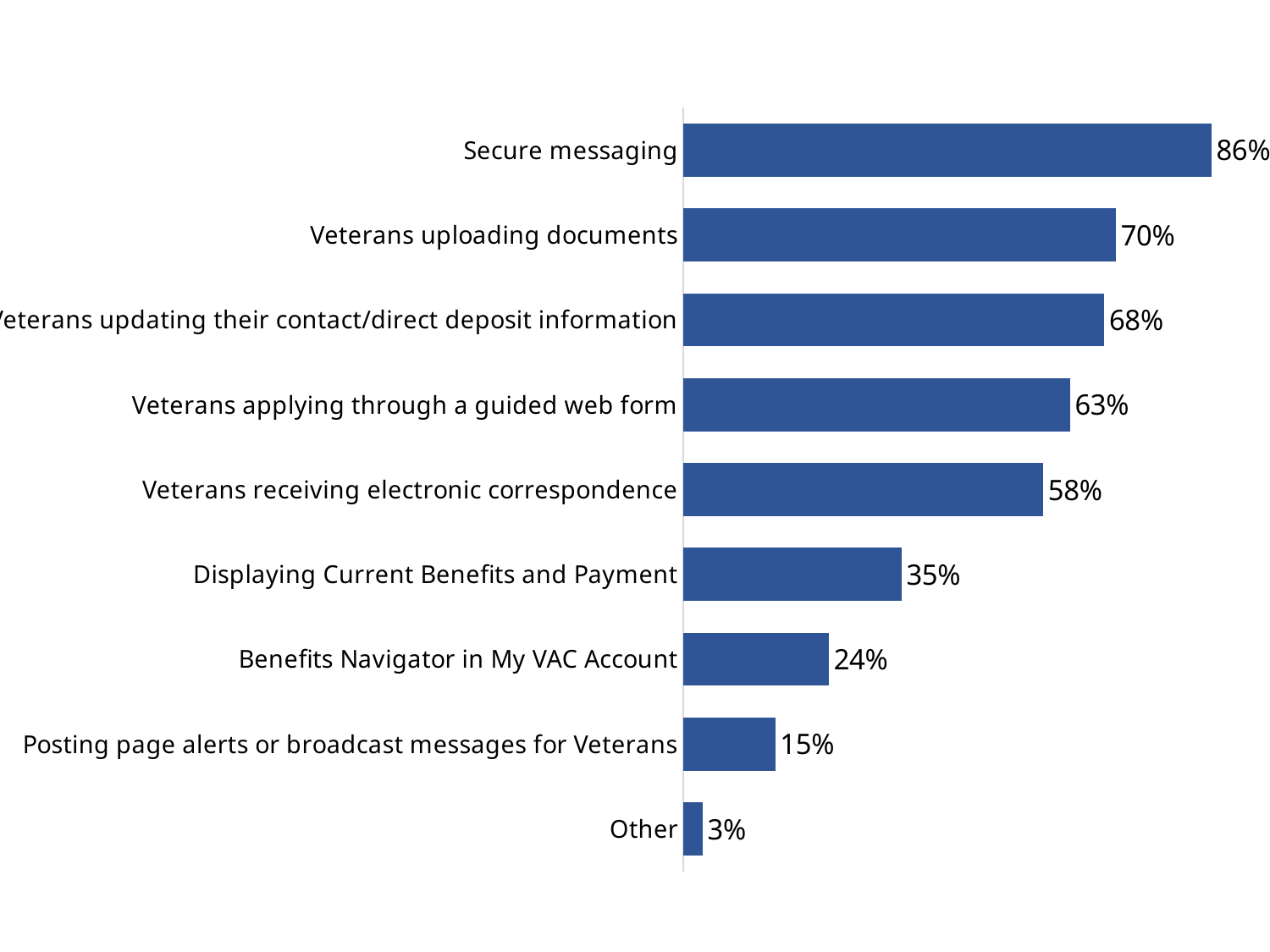
Which category has the lowest value? Other Which category has the highest value? Secure messaging What colour are the bars in the chart? Blue What is the value for Secure messaging? 86% What is the value for Posting page alerts or broadcast messages for Veterans? 15% What is the difference between Secure messaging and Veterans uploading documents? 16% Which is larger: Veterans applying through a guided web form or Veterans receiving electronic correspondence? Veterans applying through a guided web form How many categories are shown in the chart? 9 What is the value for Benefits Navigator in My VAC Account? 24% What is the difference between Displaying Current Benefits and Payment and Benefits Navigator in My VAC Account? 11% What kind of chart is this? Bar chart What is the value for Veterans uploading documents? 70%